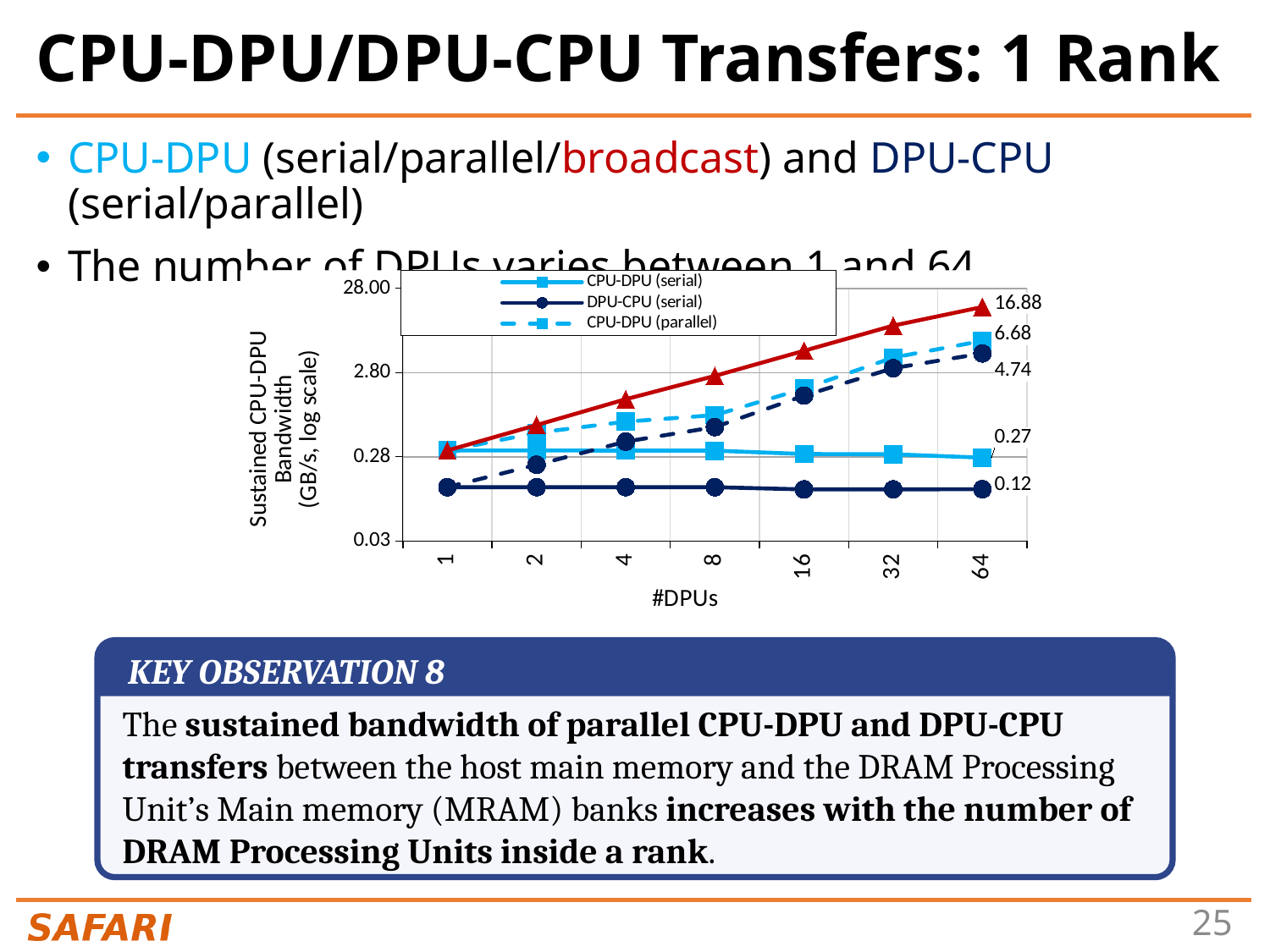
How many #DPUs values are plotted along the x axis? 7 What kind of chart is shown on the slide? line chart What is the sustained bandwidth of CPU-DPU (parallel) at 64 DPUs? 6.68 At 64 DPUs, how much higher is CPU-DPU (parallel) than CPU-DPU (serial)? 6.41 Does the CPU-DPU (parallel) bandwidth rise or fall as the number of DPUs increases? rise Is the value for DPU-CPU (serial) at 1 DPU greater or less than 0.28? less What is the highest data label printed on the chart? 16.88 What is the label of the x axis of the chart? #DPUs At 64 DPUs, what is the difference between CPU-DPU (serial) and DPU-CPU (serial)? 0.15 What is the sustained bandwidth of DPU-CPU (serial) at 64 DPUs? 0.12 At 64 DPUs, which is larger: CPU-DPU (serial) or DPU-CPU (serial)? CPU-DPU (serial) What is the sustained bandwidth of CPU-DPU (serial) at 64 DPUs? 0.27